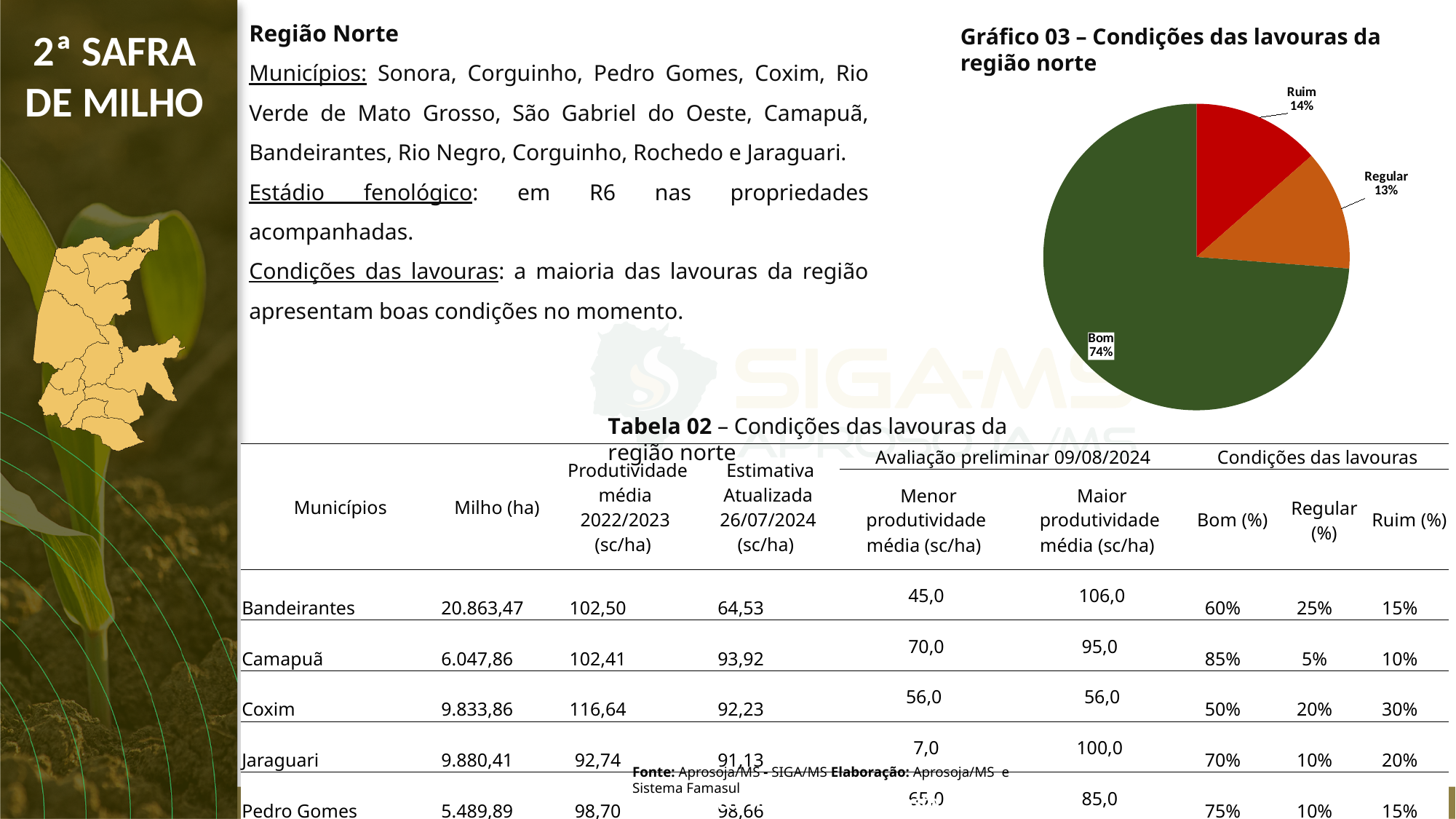
What is the value shown for Ruim in Gráfico 03? 14% What colour is the Bom slice in Gráfico 03? dark green What is the title of the pie chart on the slide? Gráfico 03 – Condições das lavouras da região norte How many slices does the pie chart in Gráfico 03 have? 3 What share of the pie in Gráfico 03 is labelled Bom? 74% In Gráfico 03, what is the difference in percentage points between the Bom slice and the Ruim slice? 60 What kind of chart is Gráfico 03 on the slide? pie chart In Gráfico 03, what is the difference in percentage points between the Ruim slice and the Regular slice? 1 In Gráfico 03, which is larger, the Ruim slice or the Regular slice? Ruim Which category has the smallest slice in Gráfico 03? Regular Which category has the largest slice in Gráfico 03? Bom What is the value shown for Regular in Gráfico 03? 13%